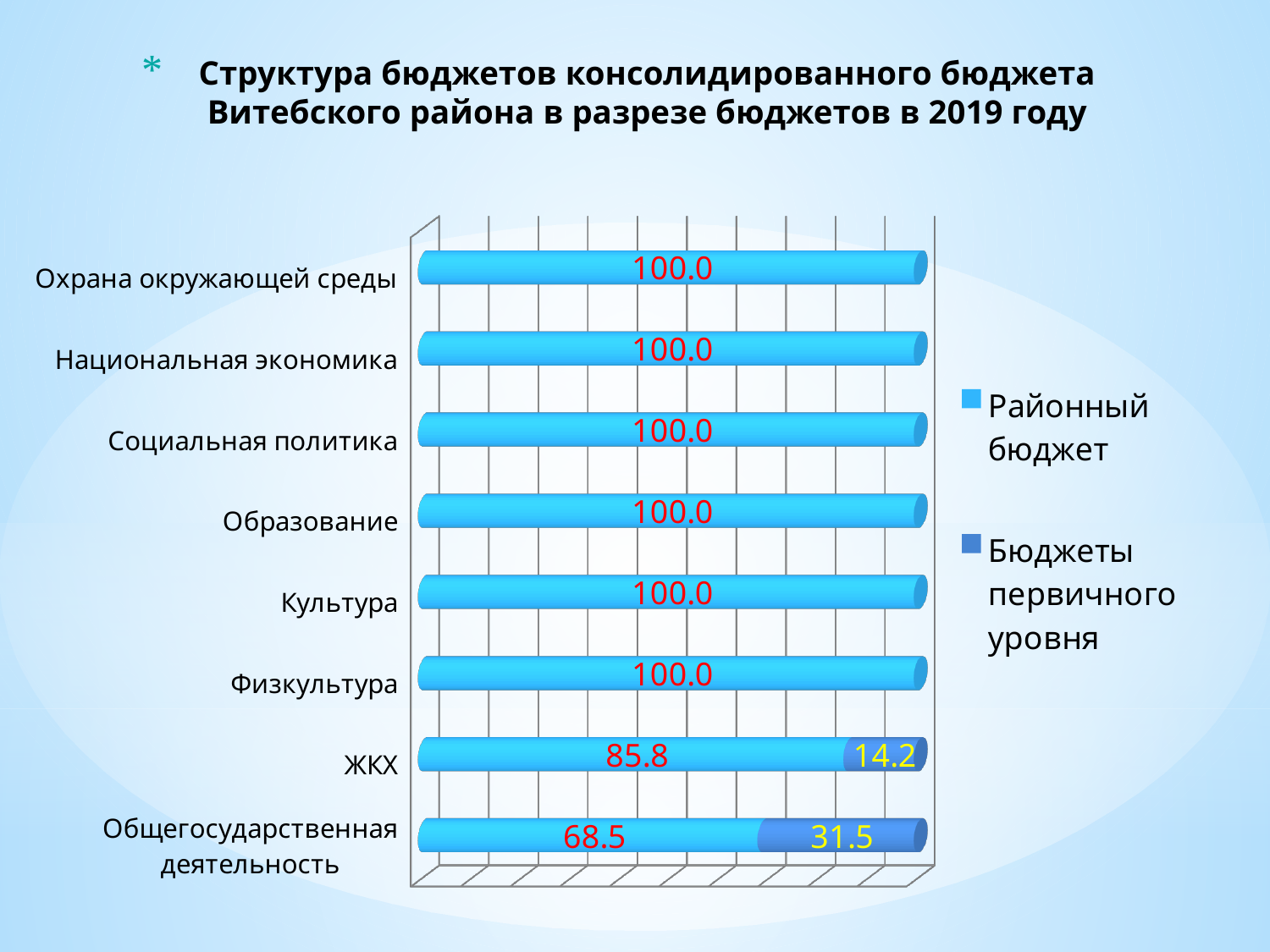
What kind of chart is shown on the slide? Stacked bar chart What is the total of the stacked bar for ЖКХ? 100.0 Which category has the highest value for Бюджеты первичного уровня? Общегосударственная деятельность Which category has the lowest value for Районный бюджет? Общегосударственная деятельность How many series does the legend list? 2 What is the value of Районный бюджет for Образование? 100.0 What is the value of Бюджеты первичного уровня for Общегосударственная деятельность? 31.5 What is the value of Бюджеты первичного уровня for ЖКХ? 14.2 Which is larger: the Бюджеты первичного уровня value for ЖКХ or for Общегосударственная деятельность? Общегосударственная деятельность What is the value of Районный бюджет for ЖКХ? 85.8 What is the difference between the Районный бюджет values for ЖКХ and Общегосударственная деятельность? 17.3 How many categories are shown on the chart? 8